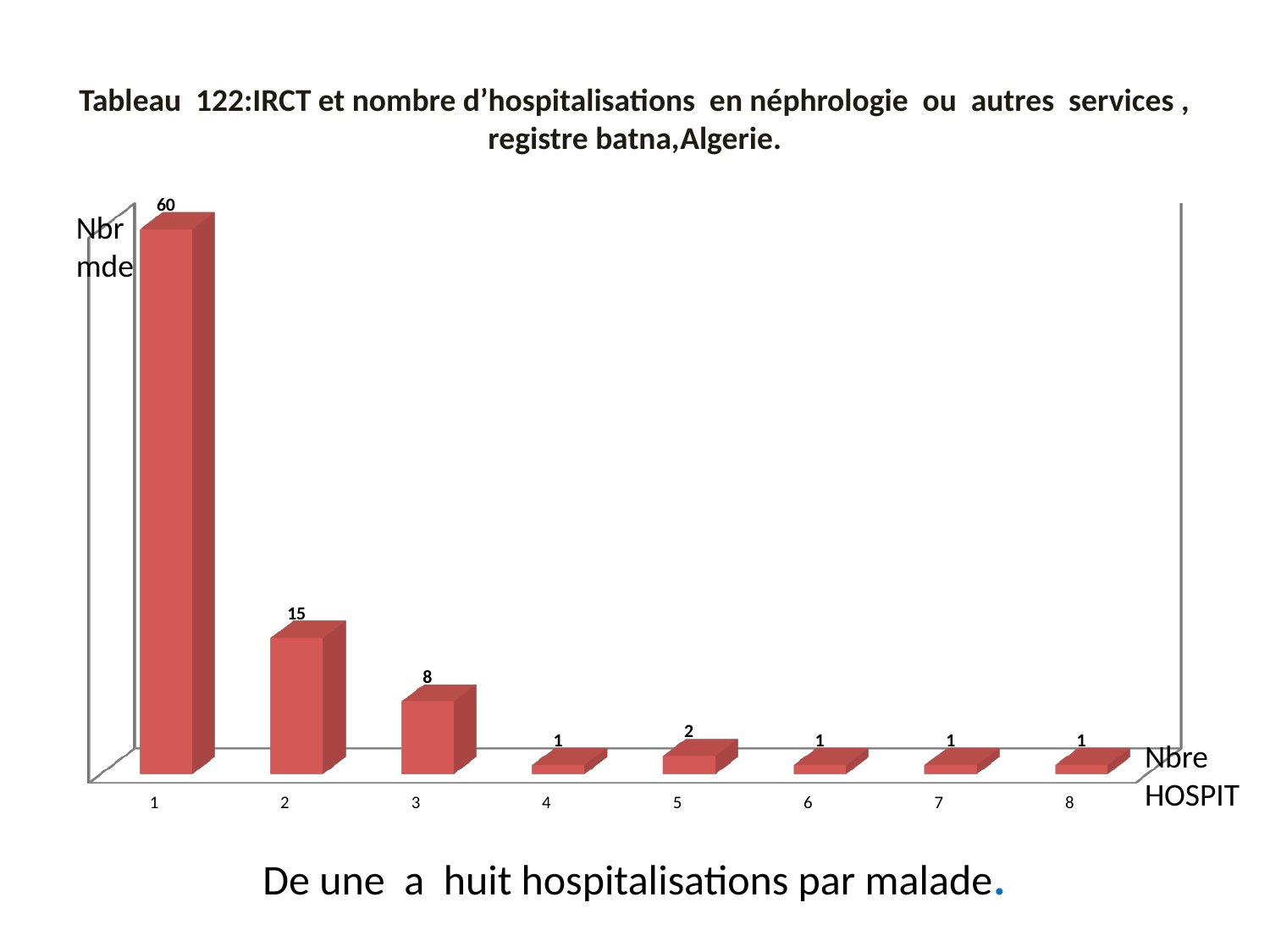
What kind of chart is shown on the slide? bar chart What is the value for category 5? 2 What is the difference between the values for category 1 and category 2? 45 What is the value for category 2? 15 Do the values generally rise or fall from category 1 to category 8? fall Which is larger, the value for category 3 or the value for category 5? category 3 What is the value for category 3? 8 What is the difference between the values for category 2 and category 3? 7 Which category has the highest value? 1 What is the label of the x axis? Nbre HOSPIT What is the value for category 1 (one hospitalisation)? 60 How many categories are shown on the x axis? 8